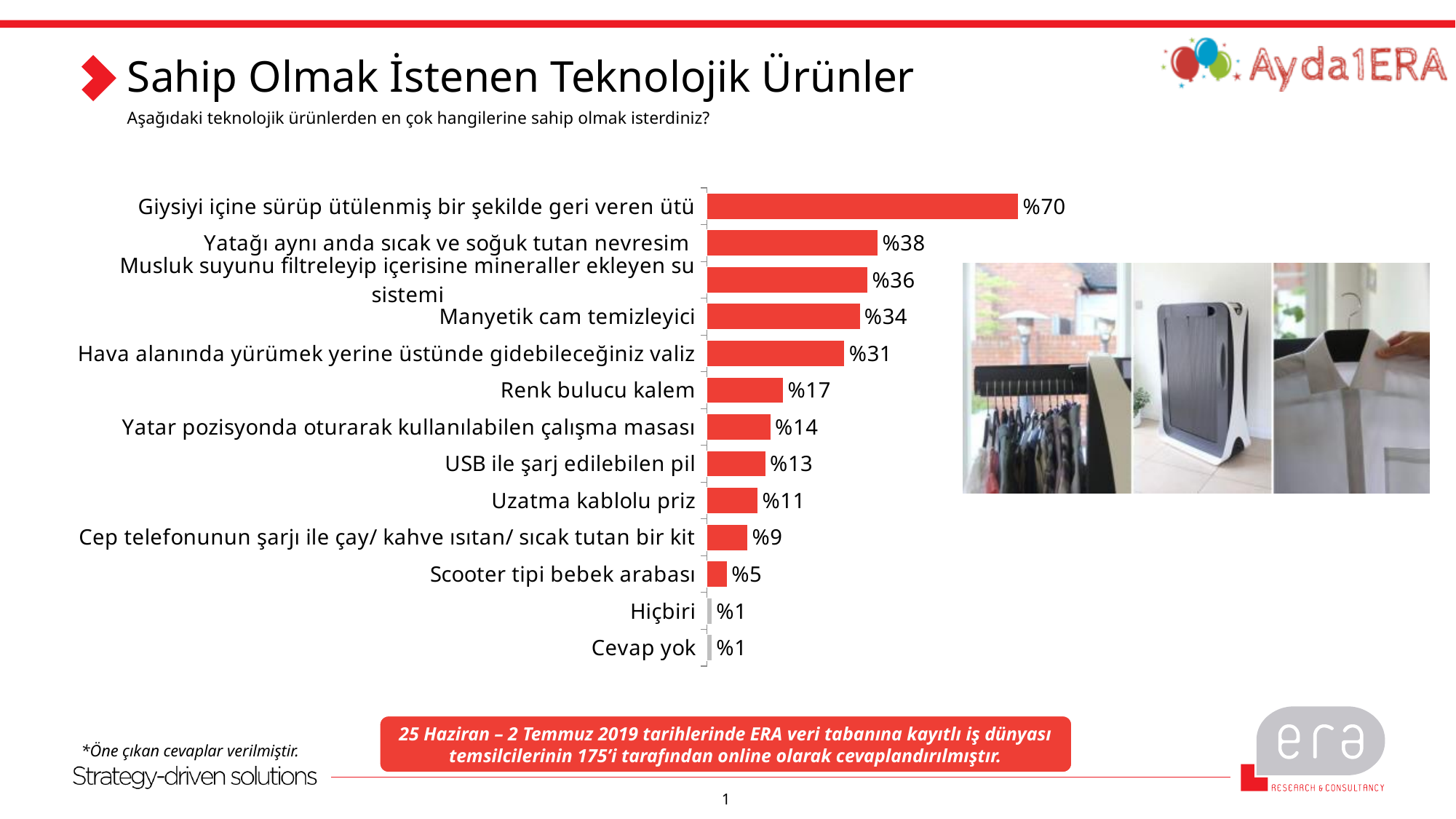
How many categories are shown in the chart? 13 What is the value for "USB ile şarj edilebilen pil"? %13 What is the difference between the values for "Giysiyi içine sürüp ütülenmiş bir şekilde geri veren ütü" and "Yatağı aynı anda sıcak ve soğuk tutan nevresim"? 32 percentage points What is the value for "Manyetik cam temizleyici"? %34 What is the title of the slide containing the chart? Sahip Olmak İstenen Teknolojik Ürünler What is the value for "Cep telefonunun şarjı ile çay/ kahve ısıtan/ sıcak tutan bir kit"? %9 What is the value for "Scooter tipi bebek arabası"? %5 What is the difference between the values for "Yatağı aynı anda sıcak ve soğuk tutan nevresim" and "Renk bulucu kalem"? 21 percentage points Which is larger: the value for "Hava alanında yürümek yerine üstünde gidebileceğiniz valiz" or the value for "Uzatma kablolu priz"? Hava alanında yürümek yerine üstünde gidebileceğiniz valiz Which category has the highest value? Giysiyi içine sürüp ütülenmiş bir şekilde geri veren ütü What kind of chart is shown on the slide? Bar chart What is the value for "Giysiyi içine sürüp ütülenmiş bir şekilde geri veren ütü"? %70